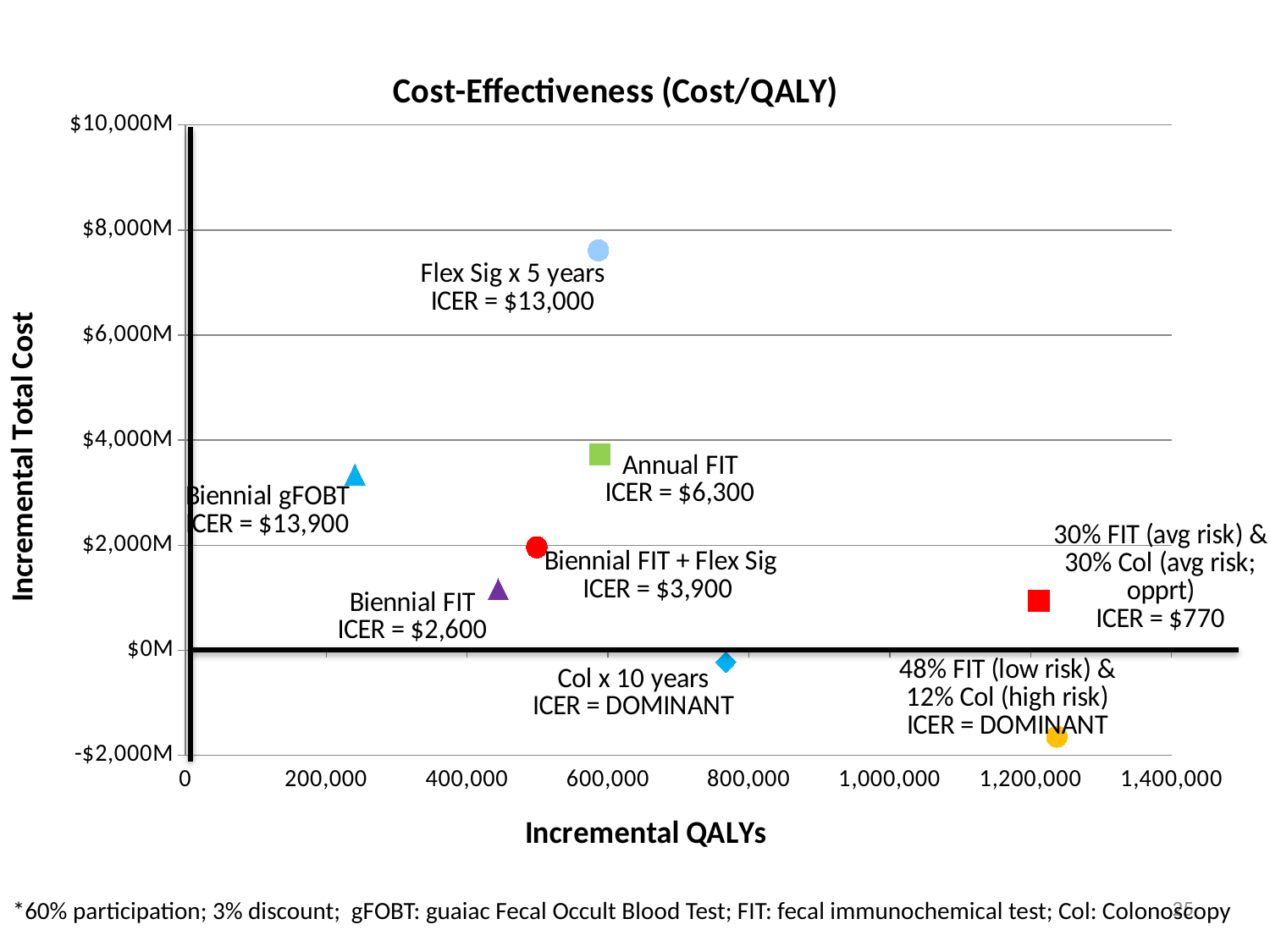
What is the ICER shown for Col x 10 years? DOMINANT What kind of chart is shown on the slide? scatter chart What is the ICER shown for the 30% FIT (avg risk) & 30% Col (avg risk; opprt) strategy? $770 How many data points are plotted on the chart? 8 What is the ICER shown for Flex Sig x 5 years? $13,000 Which strategy has the highest incremental total cost? Flex Sig x 5 years Which has the higher incremental total cost, Annual FIT or Biennial FIT + Flex Sig? Annual FIT Which strategy has the lowest incremental total cost? 48% FIT (low risk) & 12% Col (high risk) What is the ICER shown for Annual FIT? $6,300 What is the ICER shown for Biennial FIT? $2,600 Is the incremental total cost for Flex Sig x 5 years greater or less than $6,000M? greater Are the incremental QALYs for Biennial gFOBT greater or less than 400,000? less